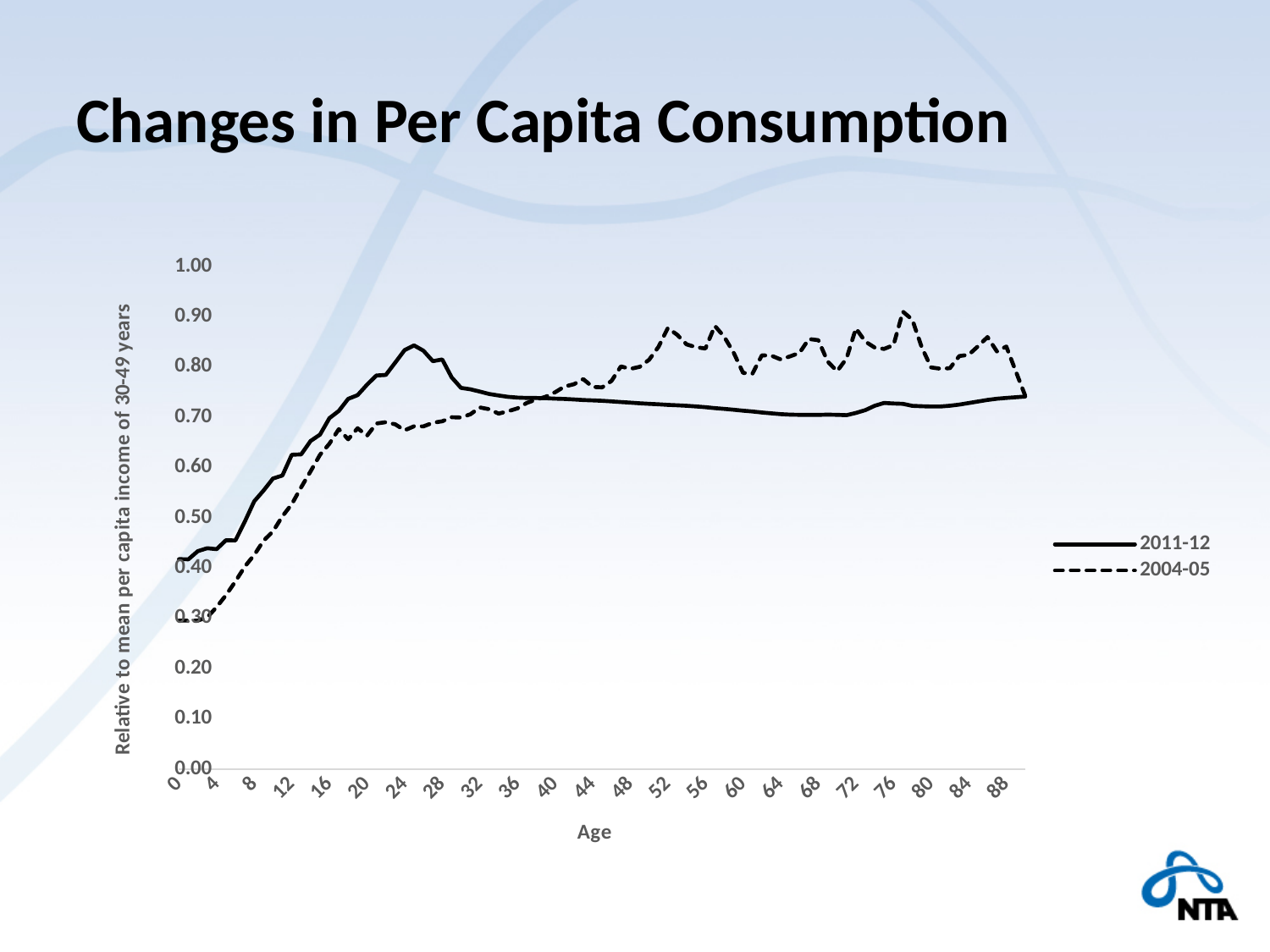
Is the value for 2011-12 at age 24 greater or less than 0.80? greater How many series does the legend list? 2 What is the title of the x axis? Age Which series is drawn with a dashed line? 2004-05 Is the value for 2004-05 at age 76 greater or less than 0.80? greater Is the value for 2011-12 at age 60 greater or less than 0.80? less At age 8, which series has the larger value, 2011-12 or 2004-05? 2011-12 At age 60, which series has the larger value, 2011-12 or 2004-05? 2004-05 Does the 2011-12 series rise or fall between age 0 and age 24? rise What kind of chart is shown on the slide? line chart